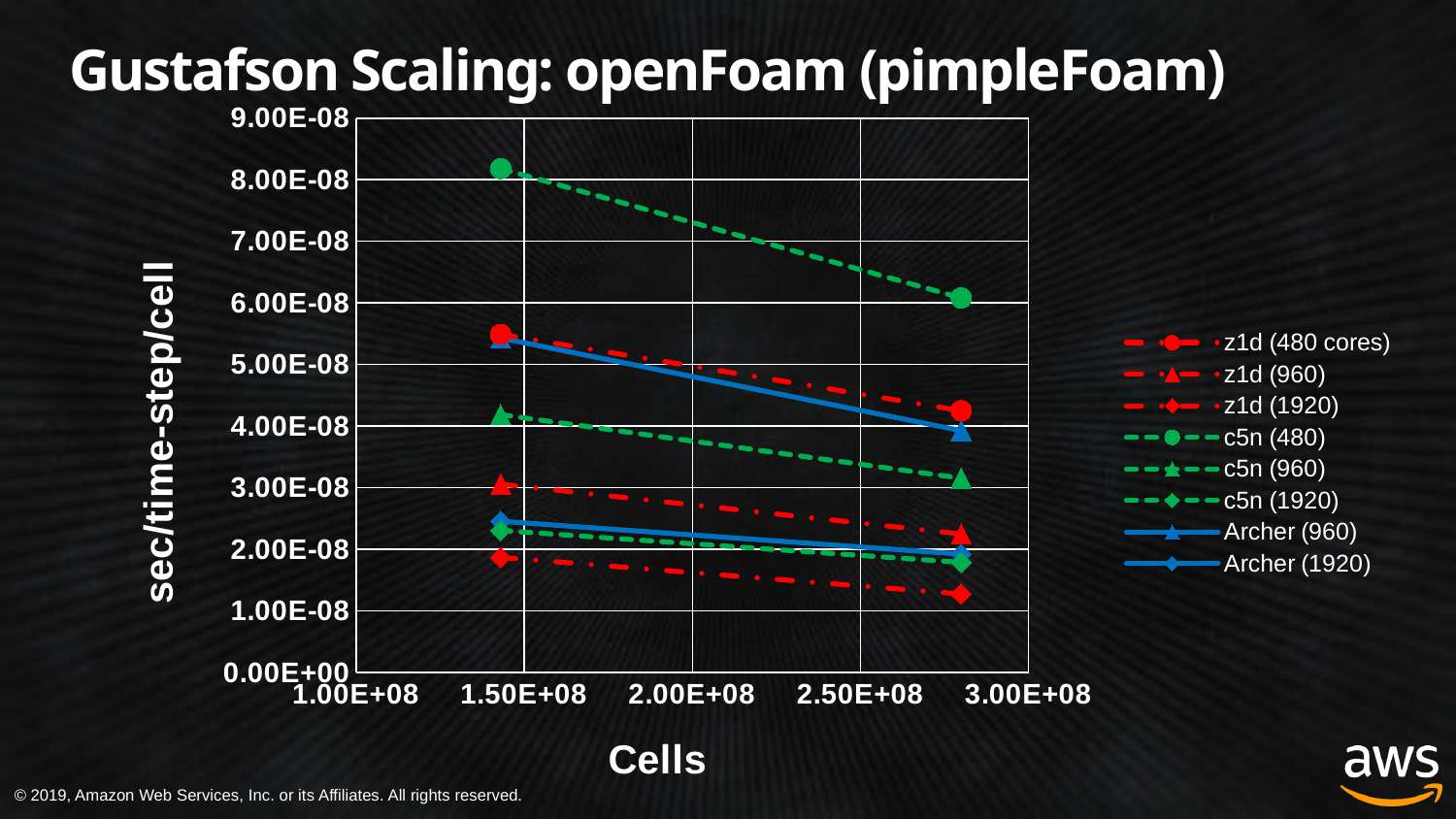
Is the value for c5n (480) at 1.50E+08 cells greater or less than 7.00E-08? greater At 1.50E+08 cells, which is larger: c5n (480) or z1d (480 cores)? c5n (480) Which series has the lowest sec/time-step/cell values across the chart? z1d (1920) Which series has the highest sec/time-step/cell value at 1.50E+08 cells? c5n (480) At 1.50E+08 cells, which is larger: z1d (960) or c5n (960)? c5n (960) How many data points does each series have? 2 Do the sec/time-step/cell values rise or fall as the number of cells increases? fall What kind of chart is shown on the slide? line chart Is the value for c5n (480) at its right-hand data point greater or less than 5.00E-08? greater How many series does the legend list? 8 Is the value for z1d (1920) at 1.50E+08 cells greater or less than 2.00E-08? less What is the label of the x axis? Cells